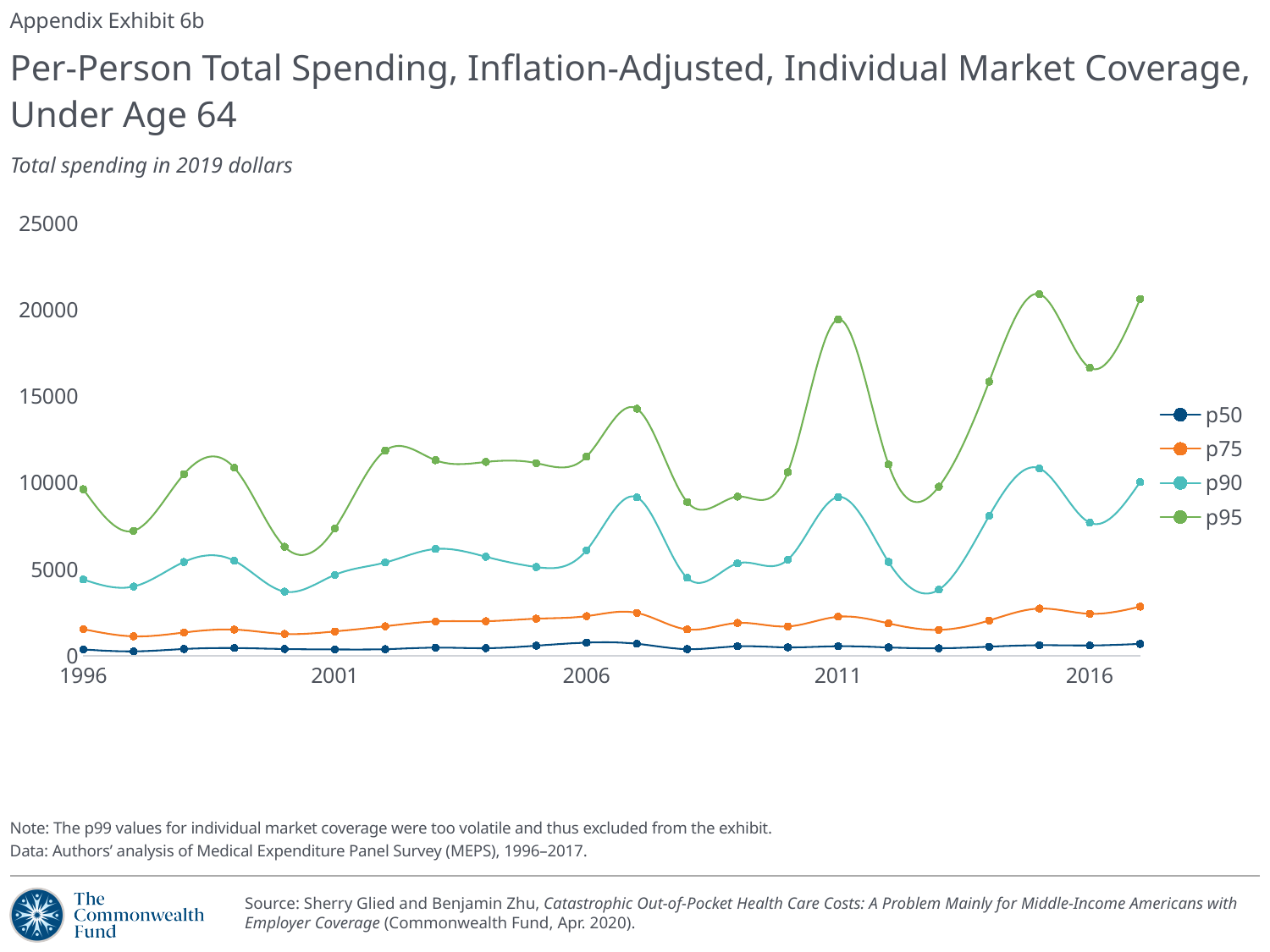
What is the subtitle describing the units of the chart? Total spending in 2019 dollars Which series has the highest values across the chart? p95 Is the value for p95 in 2011 greater or less than 15000? greater Which series has the lowest values across the chart? p50 Does the p95 line rise or fall between 2011 and 2013? fall Is the value for p90 in 2006 greater or less than 5000? greater In 2011, which is larger, the value for p95 or the value for p90? p95 How many series does the legend list? 4 What kind of chart is shown on the slide? line chart Is the value for p95 in 2001 greater or less than 10000? less